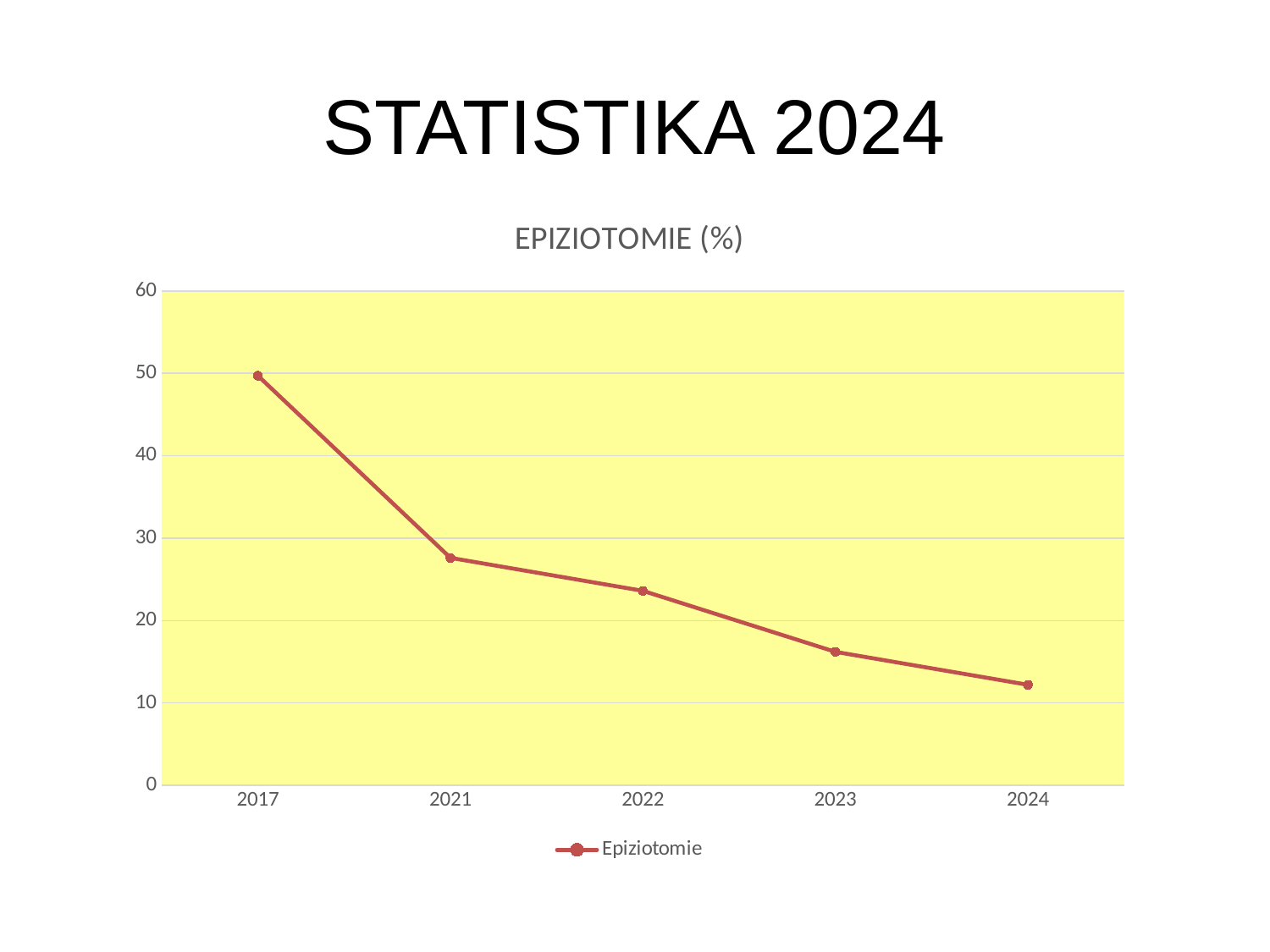
Which year has the highest value? 2017 Is the value for 2021 greater or less than 30? less Which year has the lowest value? 2024 Which is larger, the value for 2021 or the value for 2022? 2021 Is the value for 2023 greater or less than 20? less Is the value for 2024 greater or less than 10? greater Do the values rise or fall from 2017 to 2024? fall How many series does the legend list? 1 What kind of chart is shown on the slide? line chart What is the title of the chart? EPIZIOTOMIE (%) How many data points are plotted on the line? 5